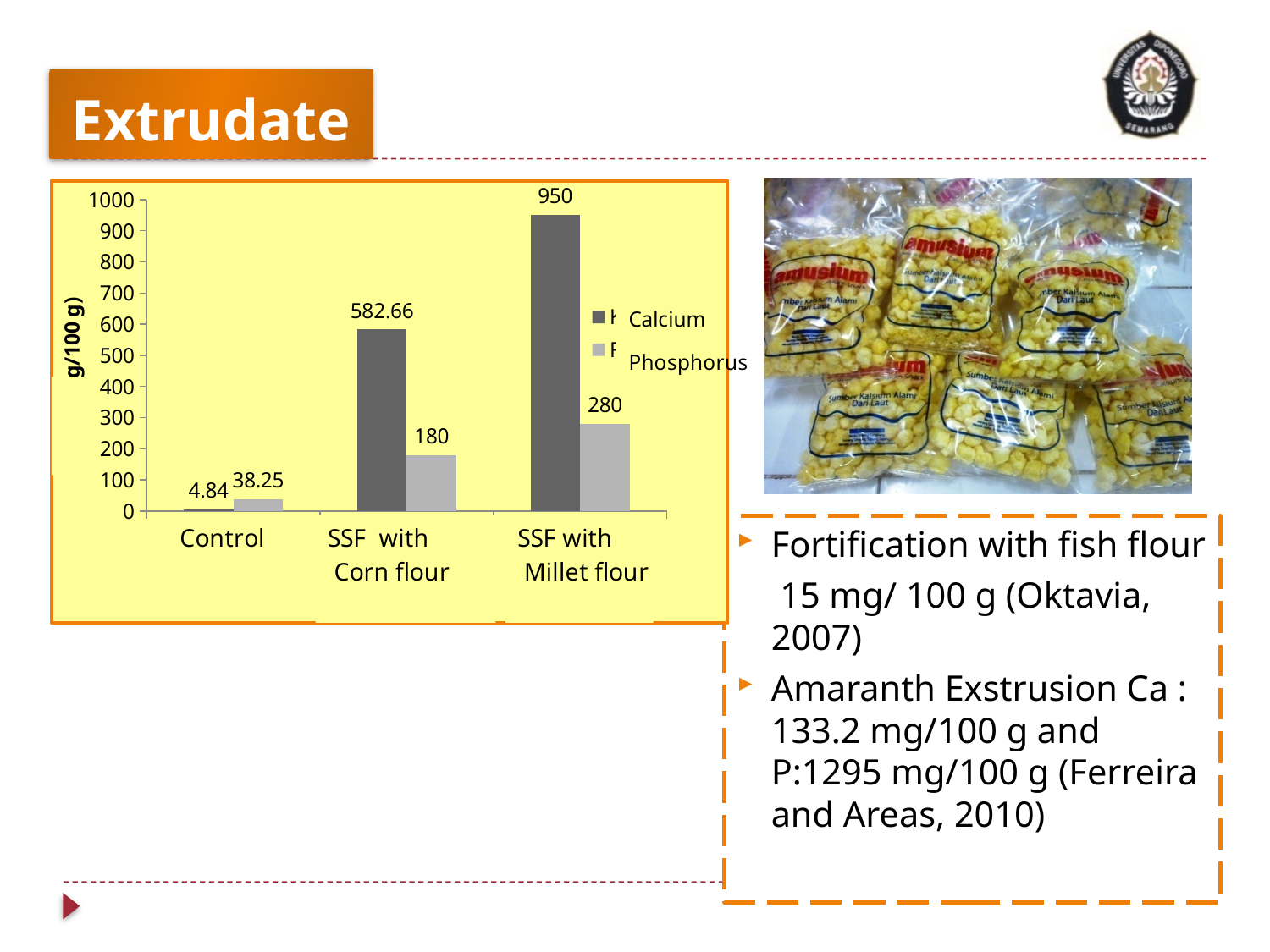
What is the difference between the Calcium and Phosphorus values for SSF with Millet flour? 670 Which is larger for SSF with Corn flour, Calcium or Phosphorus? Calcium How many series does the legend list? 2 Which category has the lowest Phosphorus value? Control Which category has the highest Calcium value? SSF with Millet flour What is the Calcium value for SSF with Millet flour? 950 What is the Calcium value for Control? 4.84 Is the Calcium value for SSF with Corn flour greater or less than 500? greater What is the Phosphorus value for Control? 38.25 What kind of chart is shown on the slide? Bar chart What is the Phosphorus value for SSF with Corn flour? 180 How many categories are shown on the x axis? 3